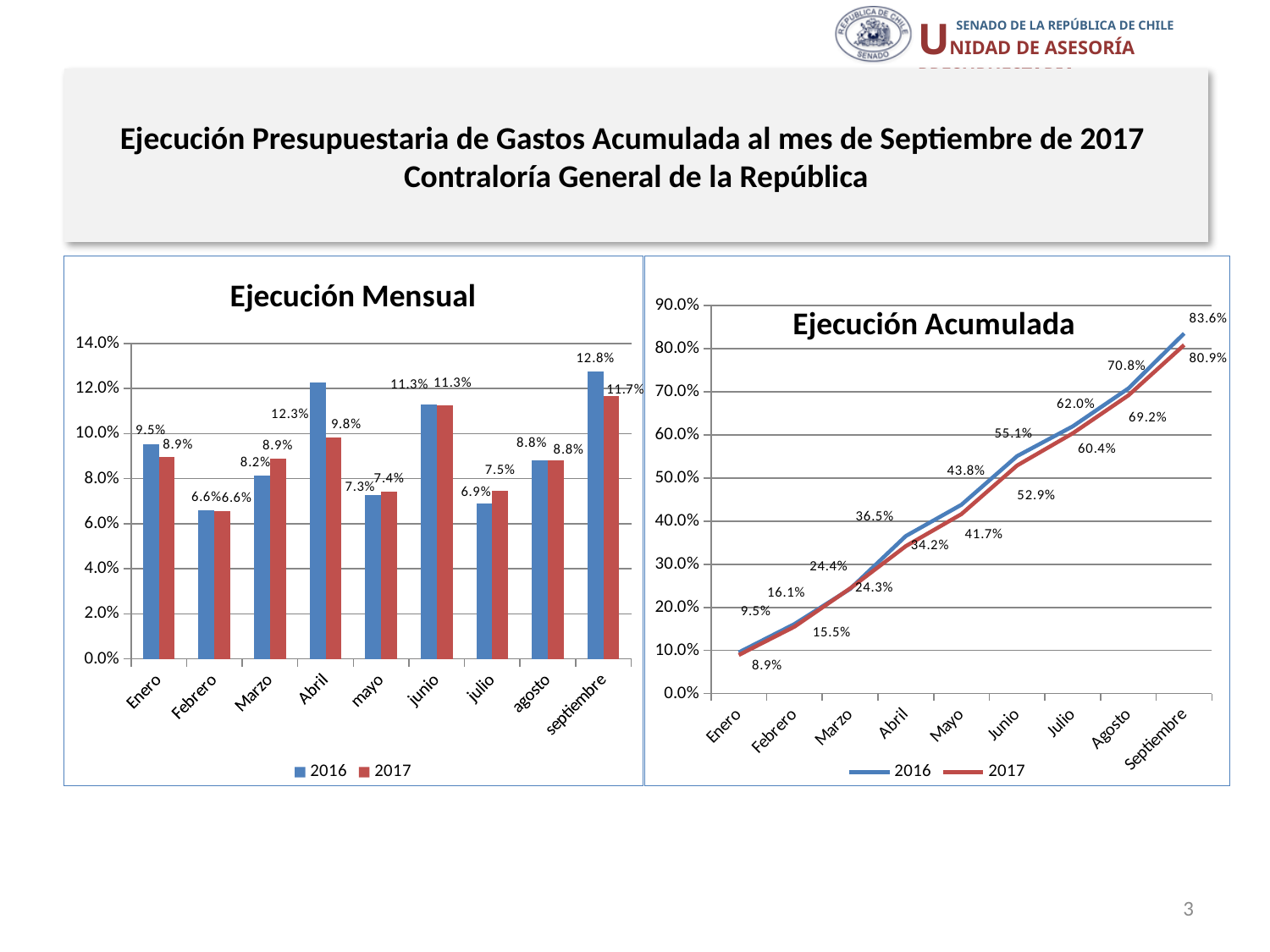
In the 'Ejecución Mensual' chart, what is the value for 2017 in septiembre? 11.7% In the 'Ejecución Mensual' chart, which month has the lowest value for 2017? Febrero In the 'Ejecución Mensual' chart, what is the value for 2016 in Abril? 12.3% What kind of chart is 'Ejecución Mensual'? bar chart How many series does the legend of the 'Ejecución Acumulada' chart list? 2 In the 'Ejecución Mensual' chart, which month has the highest value for 2016? septiembre In the 'Ejecución Acumulada' chart, what is the value for 2016 in Septiembre? 83.6% In the 'Ejecución Acumulada' chart, do the values rise or fall from Enero to Septiembre? rise In the 'Ejecución Mensual' chart, which is larger in julio: the 2016 value or the 2017 value? 2017 In the 'Ejecución Mensual' chart, what is the difference between the 2016 and 2017 values in Abril? 2.5% In the 'Ejecución Acumulada' chart, what is the value for 2017 in Junio? 52.9% In the 'Ejecución Acumulada' chart, what is the difference between the 2016 and 2017 values in Septiembre? 2.7%